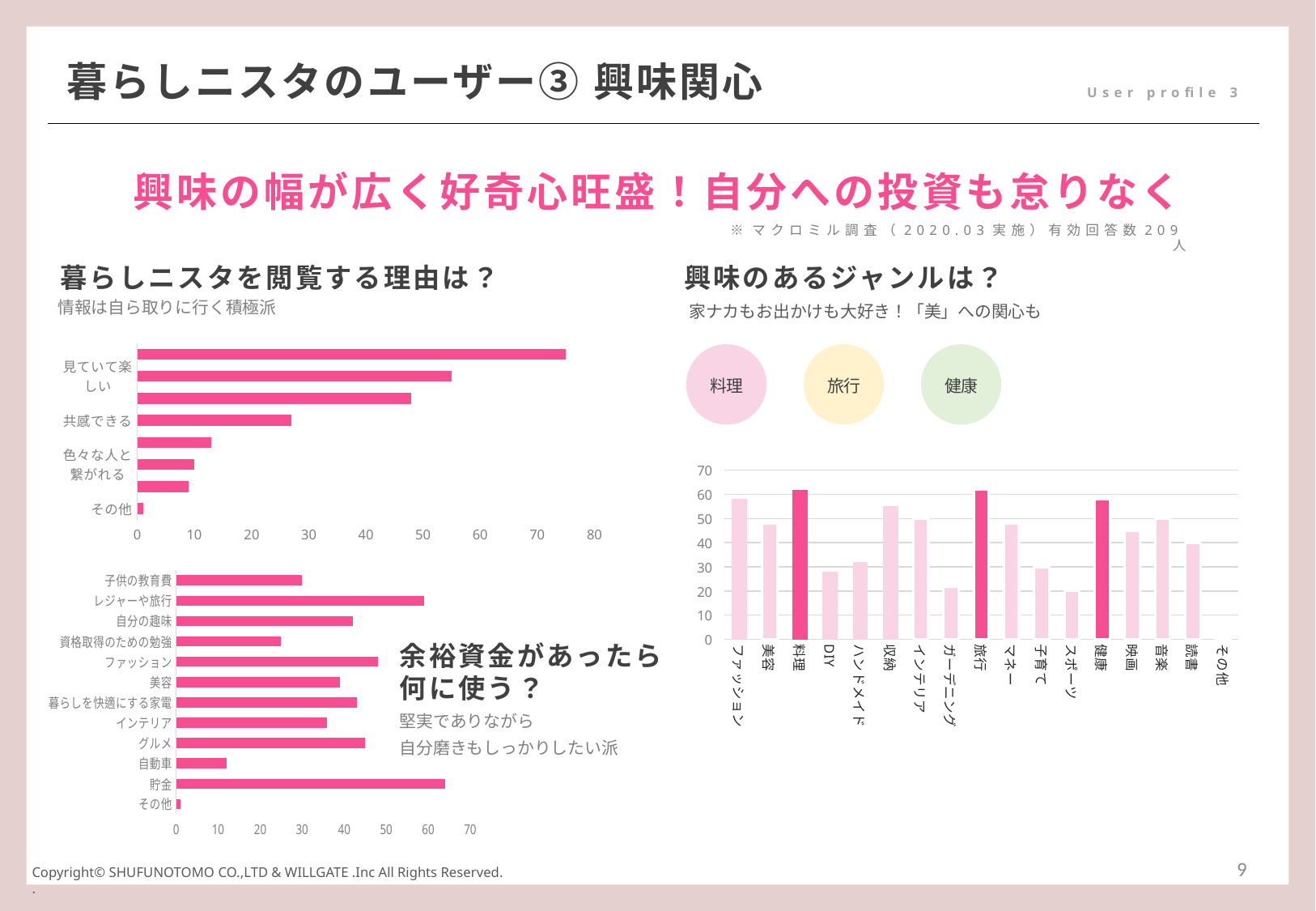
In the chart titled 「余裕資金があったら何に使う？」, which category has the shortest bar? その他 What kind of chart is the one titled 「興味のあるジャンルは？」? bar chart In the chart titled 「余裕資金があったら何に使う？」, is the value for 自動車 greater or less than 20? less In the chart titled 「興味のあるジャンルは？」, which is larger, 収納 or スポーツ? 収納 How many categories are shown in the chart titled 「興味のあるジャンルは？」? 17 In the chart titled 「興味のあるジャンルは？」, is the value for 料理 greater or less than 50? greater How many categories are shown in the chart titled 「余裕資金があったら何に使う？」? 12 In the chart titled 「暮らしニスタを閲覧する理由は？」, is the value for その他 greater or less than 10? less In the chart titled 「余裕資金があったら何に使う？」, which is larger, レジャーや旅行 or 子供の教育費? レジャーや旅行 In the chart titled 「余裕資金があったら何に使う？」, which category has the longest bar? 貯金